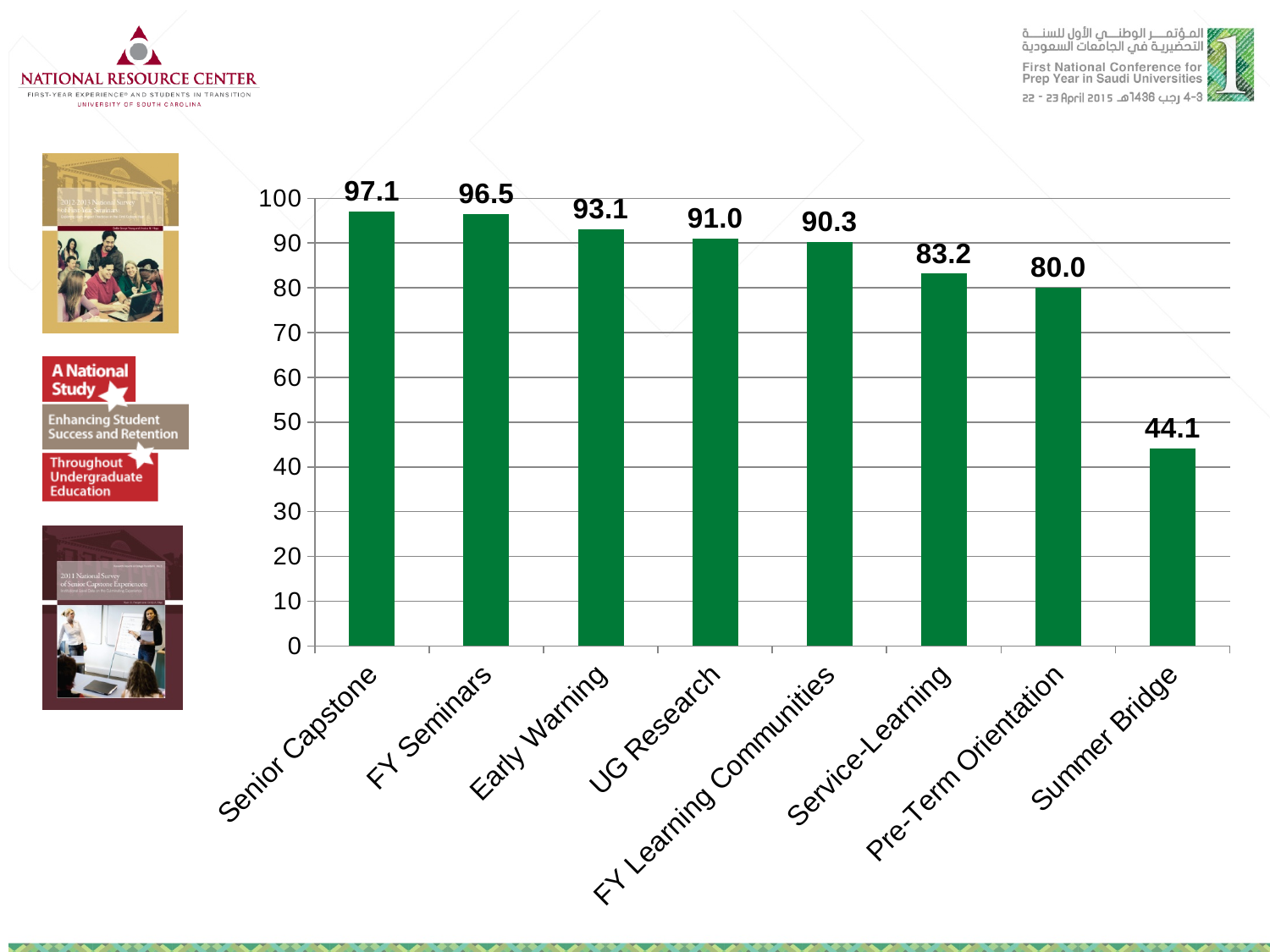
What is the value for Summer Bridge? 44.1 What is the value for Senior Capstone? 97.1 Is the value for Pre-Term Orientation greater or less than 90? less What is the difference between the values for Senior Capstone and Summer Bridge? 53.0 What is the difference between the values for Early Warning and Pre-Term Orientation? 13.1 Which category has the lowest value? Summer Bridge What is the value for Service-Learning? 83.2 What kind of chart is shown on the slide? bar chart Which is larger, the value for UG Research or the value for Service-Learning? UG Research How many categories are shown on the x axis? 8 Do the values rise or fall from left to right along the x axis? fall Which category has the highest value? Senior Capstone